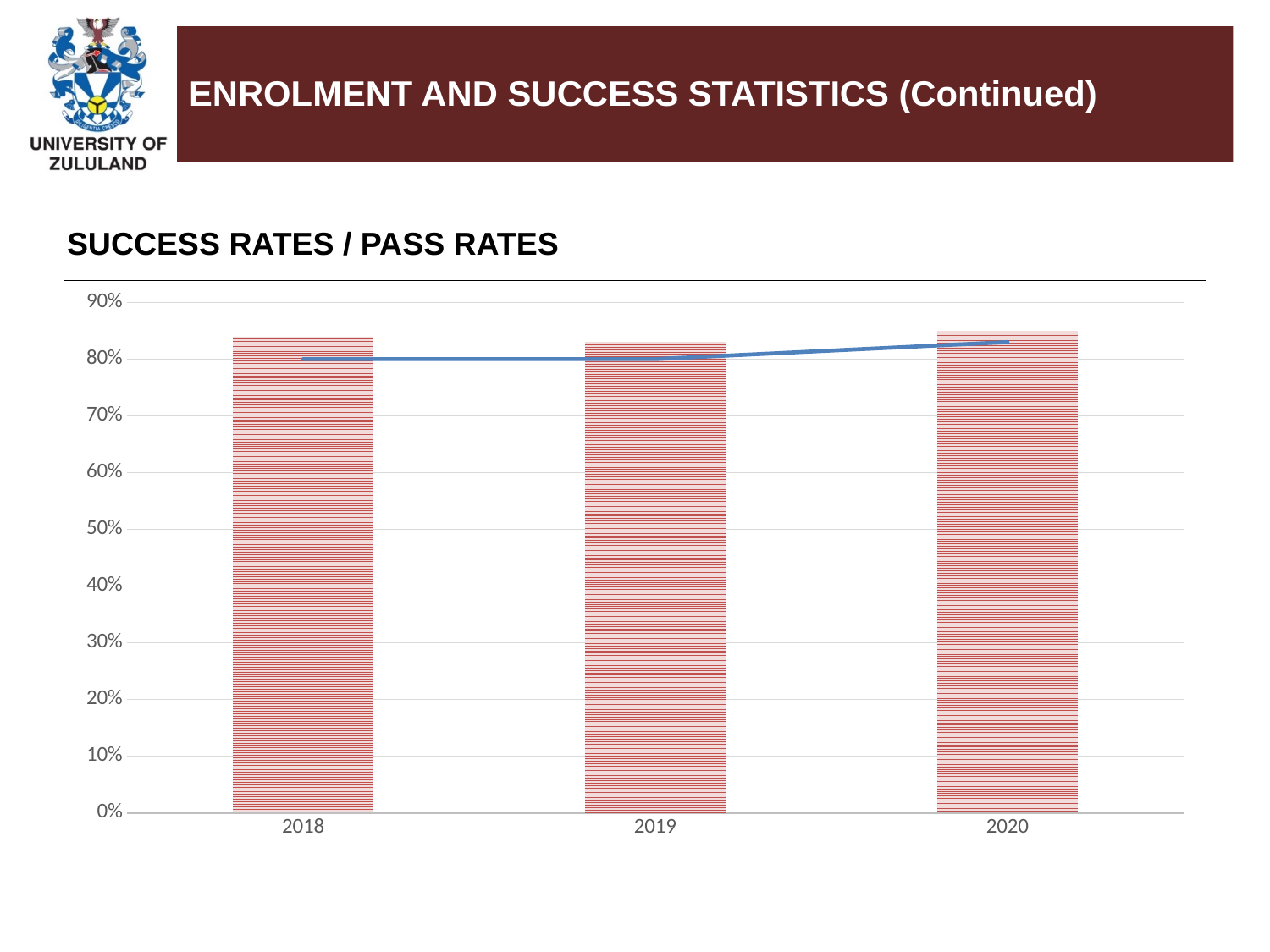
Is the bar value for 2018 greater or less than 80%? greater What is the highest value shown on the y axis of the chart? 90% What is the heading shown above the chart? SUCCESS RATES / PASS RATES Does the bar value rise or fall from 2019 to 2020? rise Which bar is taller, 2019 or 2020? 2020 Is the bar value for 2020 greater or less than 90%? less What colour is the line plotted across the bars? Blue Is the bar value for 2020 greater or less than 80%? greater What kind of chart is shown on the slide? Bar chart (with a line overlay) How many years are shown on the x axis of the chart? 3 Which year has the highest bar in the chart? 2020